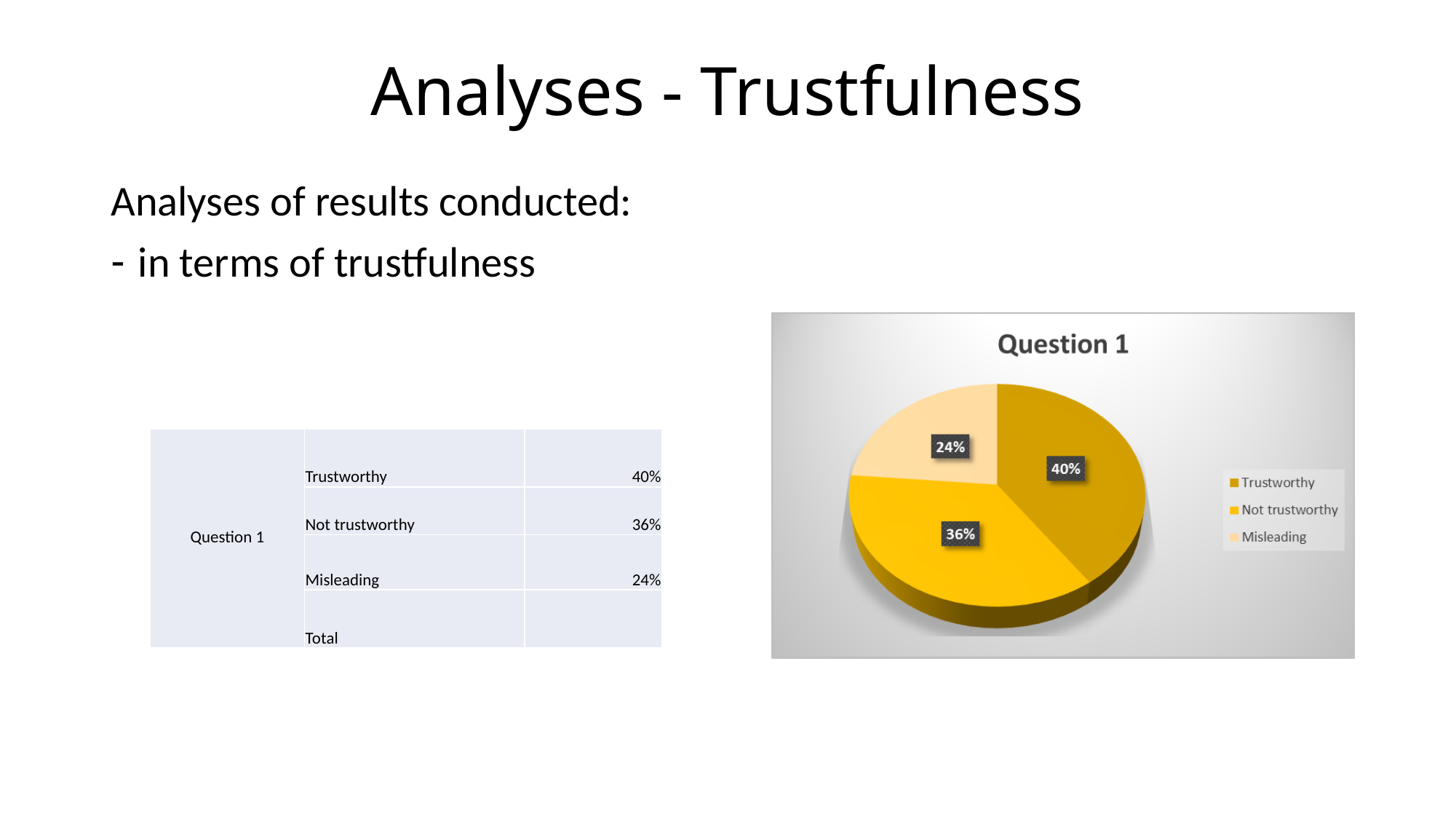
Which is larger, the Trustworthy slice or the Not trustworthy slice? Trustworthy What percentage of the pie is labelled Trustworthy? 40% Which category has the smallest slice of the pie? Misleading What is the difference between the Not trustworthy and Misleading shares? 12% What kind of chart is shown on the slide? pie chart What percentage of the pie is labelled Not trustworthy? 36% Which category has the largest slice of the pie? Trustworthy How many entries does the legend list? 3 What is the difference between the Trustworthy and Misleading shares? 16% How many slices does the pie chart have? 3 What is the title of the chart? Question 1 What percentage of the pie is labelled Misleading? 24%